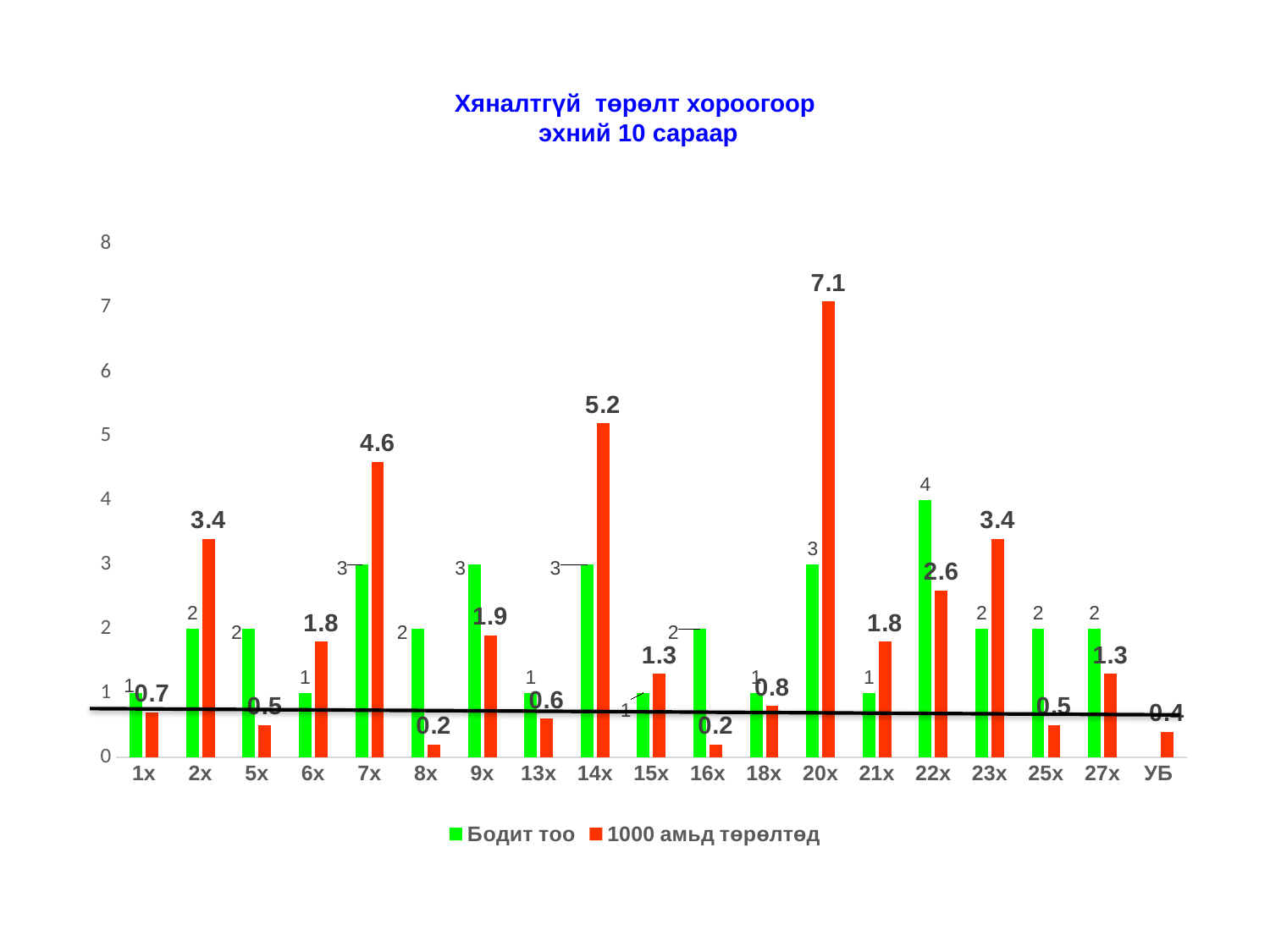
How many series does the legend list? 2 How many categories are shown on the x axis? 19 Which category has the highest value in the 'Бодит тоо' series? 22х What is the value of the '1000 амьд төрөлтөд' series for УБ? 0.4 What is the value of the 'Бодит тоо' series for 22х? 4 Which category has the highest value in the '1000 амьд төрөлтөд' series? 20х What is the value of the '1000 амьд төрөлтөд' series for 7х? 4.6 What is the value of the '1000 амьд төрөлтөд' series for 20х? 7.1 What colour represents the 'Бодит тоо' series? Green What kind of chart is shown on the slide? Bar chart Which is larger: the '1000 амьд төрөлтөд' value for 2х or for 9х? 2х What is the difference between the '1000 амьд төрөлтөд' values for 20х and 14х? 1.9